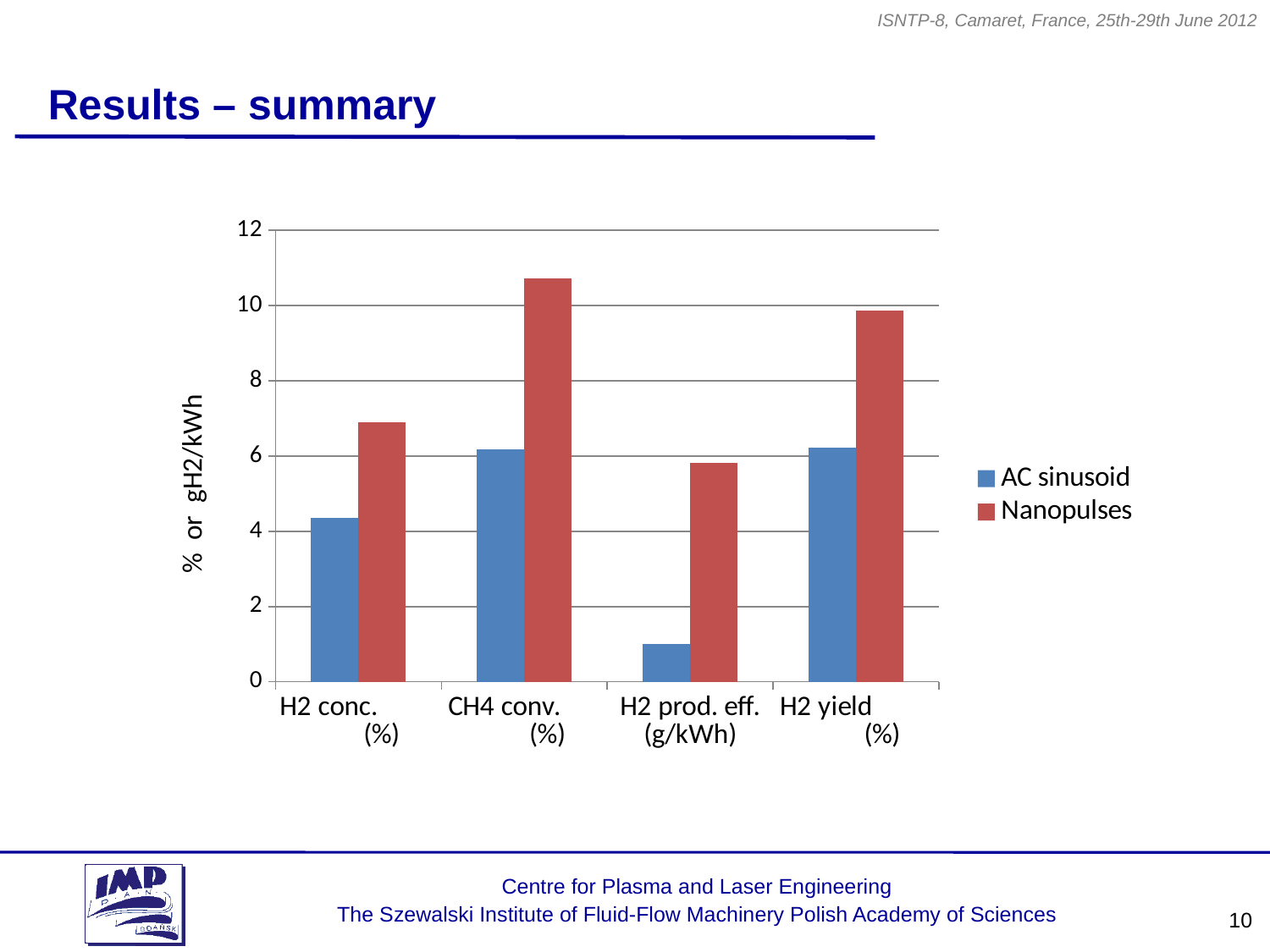
Which category has the highest Nanopulses value? CH4 conv. (%) How many series does the legend list? 2 Is the Nanopulses value for H2 conc. greater or less than 6? greater What kind of chart is shown on the slide? bar chart Which category has the lowest AC sinusoid value? H2 prod. eff. (g/kWh) Is the AC sinusoid value for H2 conc. greater or less than 6? less What is the label on the vertical axis? % or gH2/kWh Is the Nanopulses value for CH4 conv. greater or less than 10? greater Which is larger: the Nanopulses value for H2 conc. or the Nanopulses value for H2 prod. eff.? H2 conc. For H2 yield, which series has the larger value, AC sinusoid or Nanopulses? Nanopulses How many categories are shown on the x axis? 4